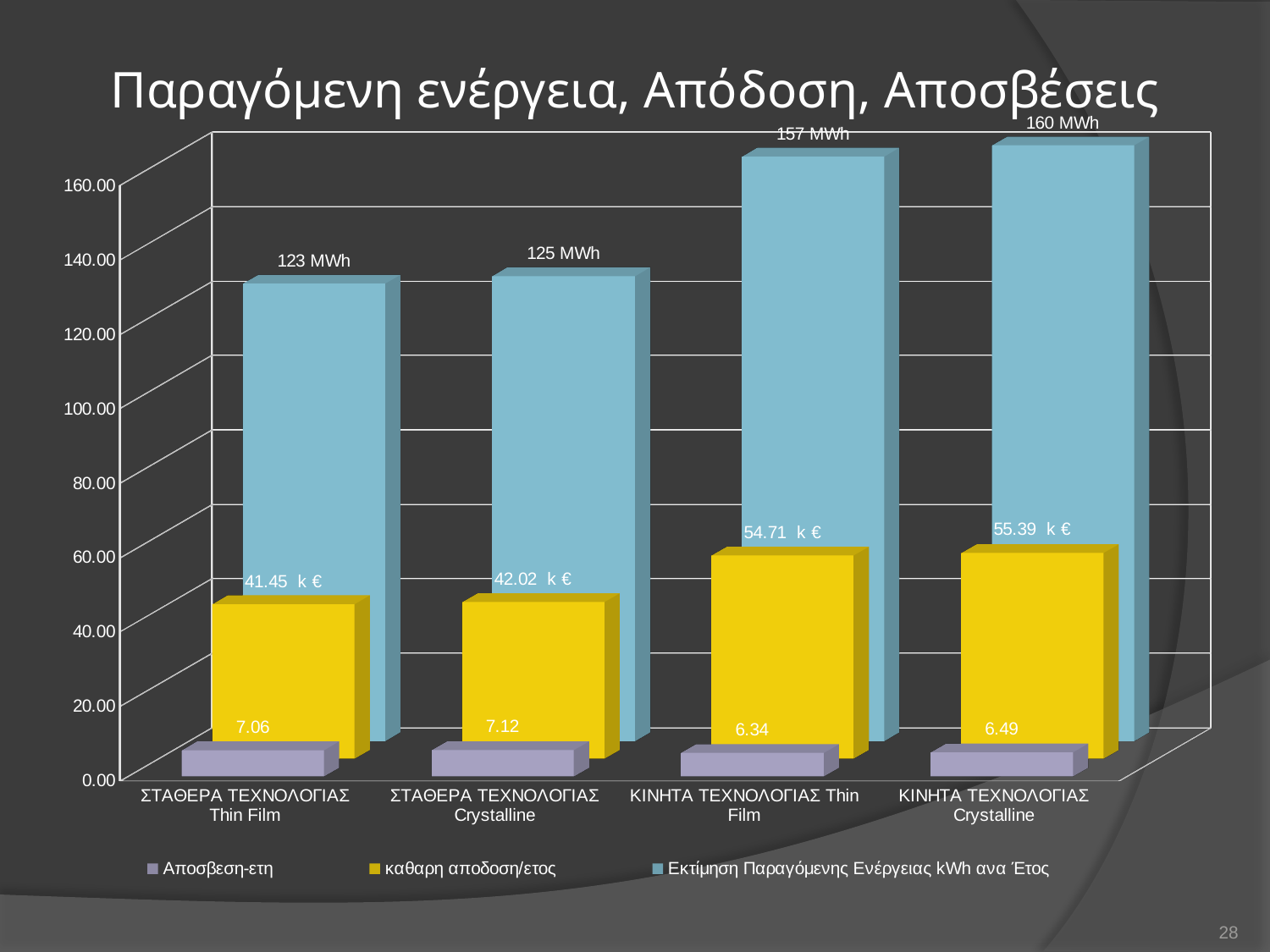
What is the difference in estimated energy production between ΚΙΝΗΤΑ ΤΕΧΝΟΛΟΓΙΑΣ Thin Film and ΣΤΑΘΕΡΑ ΤΕΧΝΟΛΟΓΙΑΣ Thin Film? 34 MWh Which category has the highest estimated energy production? ΚΙΝΗΤΑ ΤΕΧΝΟΛΟΓΙΑΣ Crystalline What type of chart is shown on the slide? bar chart What is the payback period (Αποσβεση-ετη) for ΚΙΝΗΤΑ ΤΕΧΝΟΛΟΓΙΑΣ Thin Film? 6.34 What is the net return per year (καθαρη αποδοση/ετος) for ΣΤΑΘΕΡΑ ΤΕΧΝΟΛΟΓΙΑΣ Thin Film? 41.45 k € How many categories are shown on the x axis? 4 What is the estimated energy production (Εκτίμηση Παραγόμενης Ενέργειας) for ΚΙΝΗΤΑ ΤΕΧΝΟΛΟΓΙΑΣ Crystalline? 160 MWh Which category has the lowest payback period (Αποσβεση-ετη)? ΚΙΝΗΤΑ ΤΕΧΝΟΛΟΓΙΑΣ Thin Film Is the estimated energy production for ΣΤΑΘΕΡΑ ΤΕΧΝΟΛΟΓΙΑΣ Crystalline greater or less than 140? less How many series does the legend list? 3 What is the title of the chart on the slide? Παραγόμενη ενέργεια, Απόδοση, Αποσβέσεις Which is larger, the net return per year for ΣΤΑΘΕΡΑ ΤΕΧΝΟΛΟΓΙΑΣ Crystalline or for ΚΙΝΗΤΑ ΤΕΧΝΟΛΟΓΙΑΣ Crystalline? ΚΙΝΗΤΑ ΤΕΧΝΟΛΟΓΙΑΣ Crystalline